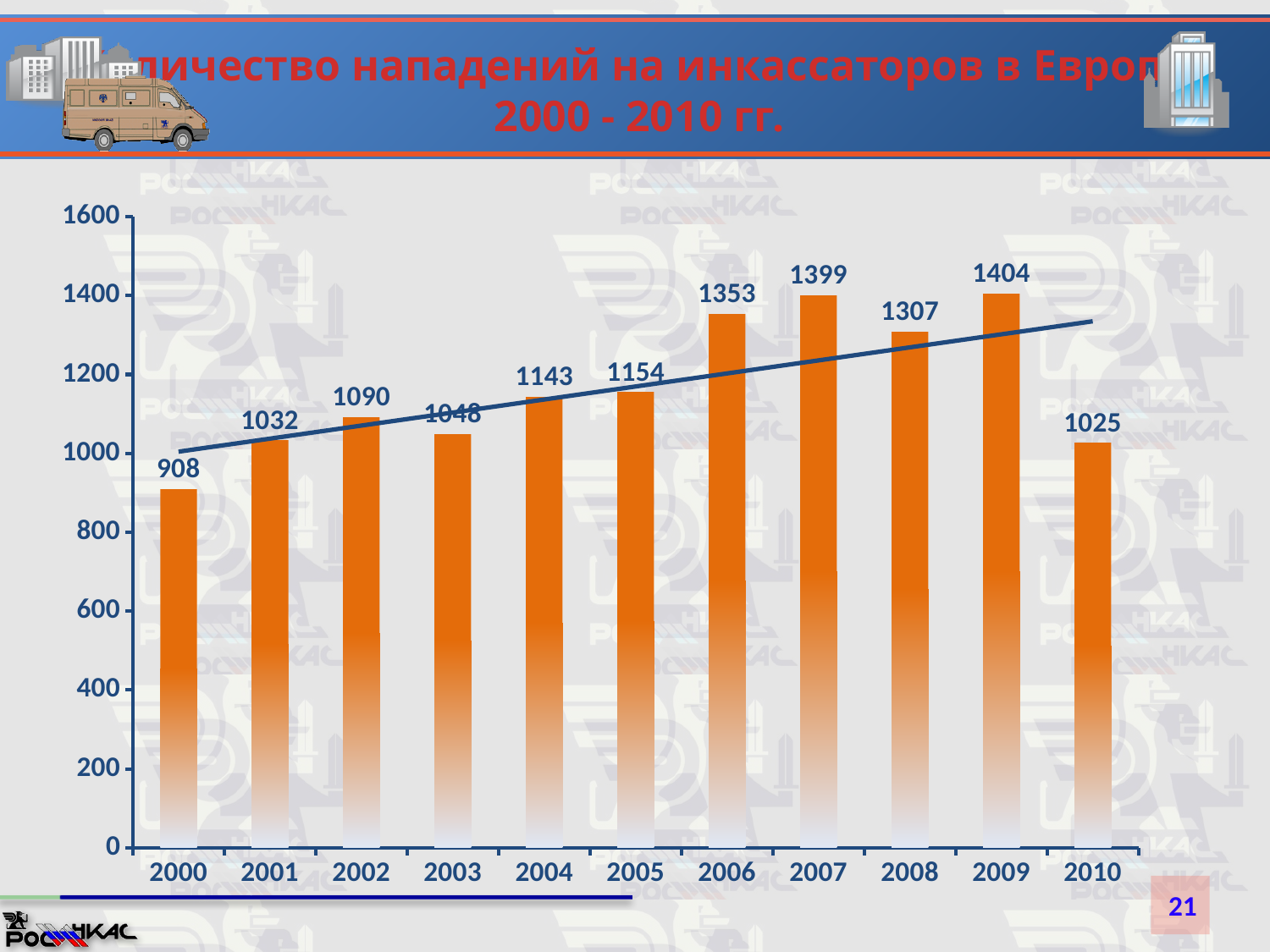
What is the difference between the values for 2009 and 2000? 496 What kind of chart is this? bar chart Which year has the lowest value? 2000 How many years are shown on the x axis? 11 Does the value rise or fall from 2009 to 2010? fall Which is larger, the value for 2003 or the value for 2002? 2002 What is the value for 2010? 1025 What is the value for 2006? 1353 Which year has the highest value? 2009 What is the value for 2000? 908 What is the difference between the values for 2007 and 2008? 92 Is the value for 2005 greater or less than 1200? less